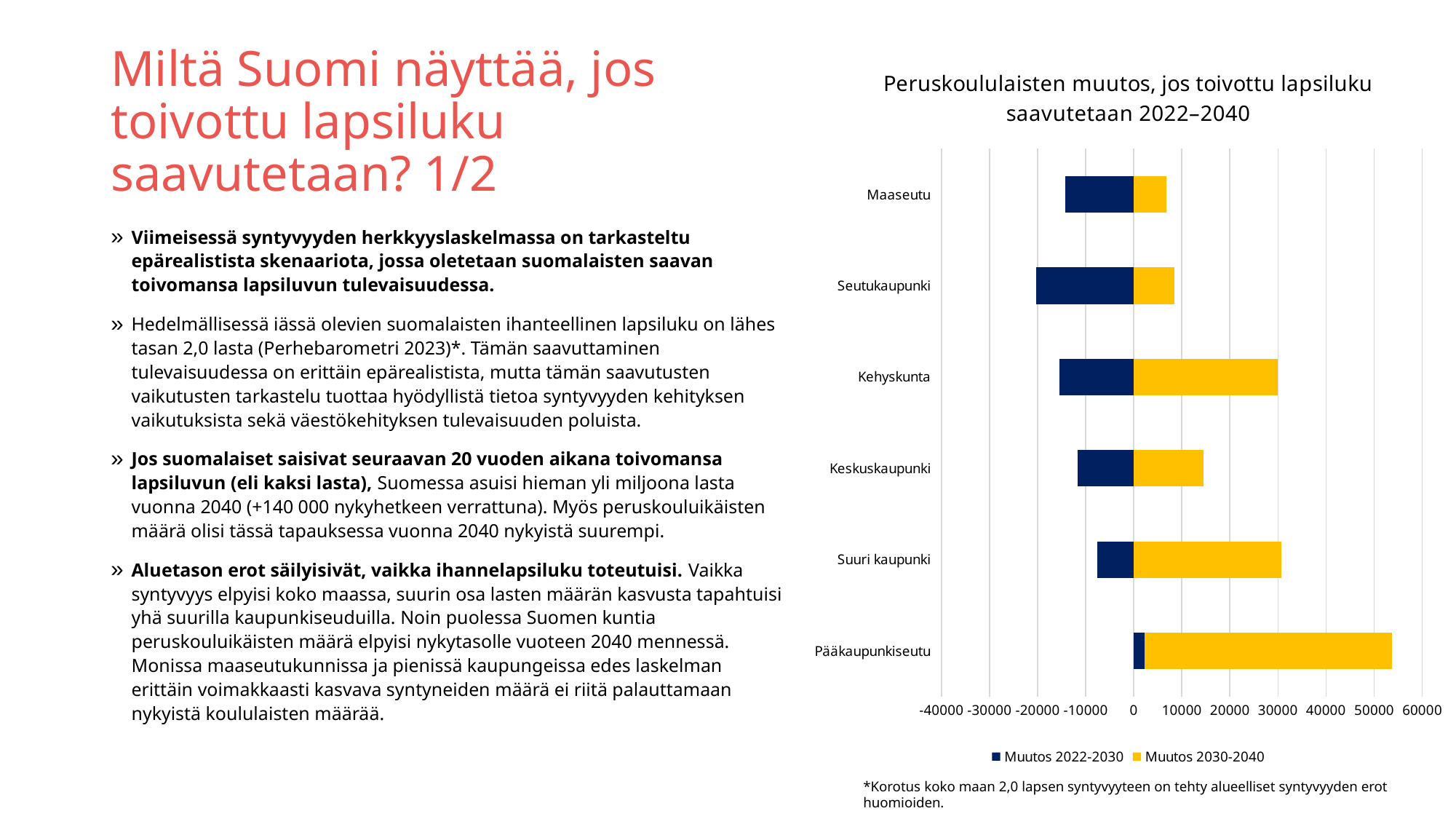
Which category has the smallest (most negative) Muutos 2022-2030 value? Seutukaupunki Which category has the largest Muutos 2030-2040 value? Pääkaupunkiseutu Is the Muutos 2030-2040 value for Pääkaupunkiseutu greater or less than 50000? greater What is the title of the chart? Peruskoululaisten muutos, jos toivottu lapsiluku saavutetaan 2022–2040 Which has the larger Muutos 2030-2040 value, Pääkaupunkiseutu or Maaseutu? Pääkaupunkiseutu Is the Muutos 2022-2030 value for Maaseutu greater or less than -10000? less Is the Muutos 2030-2040 value for Maaseutu greater or less than 10000? less Which series is shown in yellow in the chart? Muutos 2030-2040 How many regional categories are shown on the chart? 6 What kind of chart is shown on the slide? bar chart How many series does the chart legend list? 2